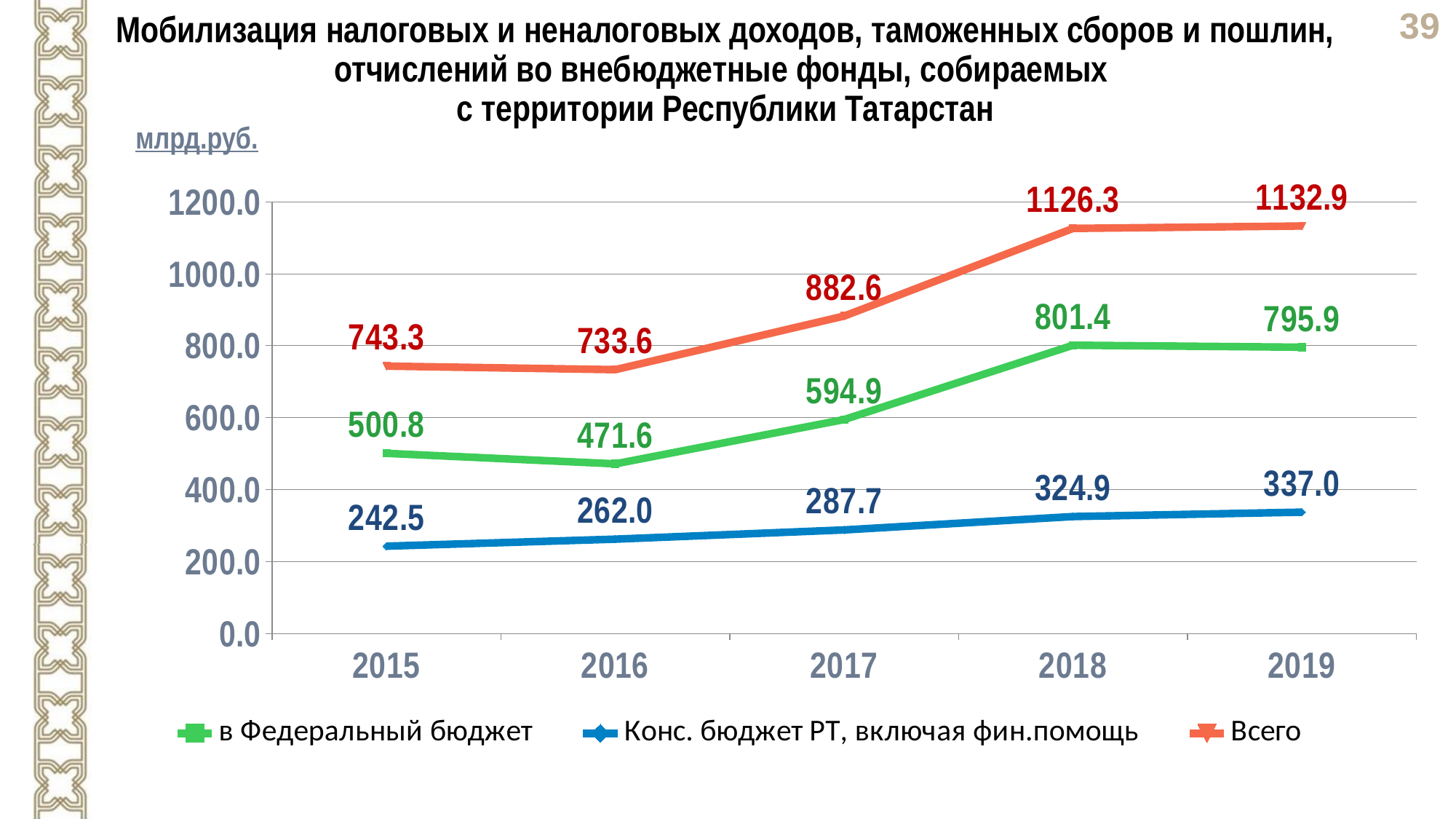
What is the difference between the 'Конс. бюджет РТ, включая фин.помощь' values in 2019 and 2015? 94.5 In which year is the 'Всего' series at its lowest? 2016 What is the value of the 'Конс. бюджет РТ, включая фин.помощь' series in 2017? 287.7 In which year is the 'в Федеральный бюджет' series at its highest? 2018 What kind of chart is shown on the slide? line chart How many years are shown on the x axis? 5 What is the value of the 'Всего' series in 2019? 1132.9 How many series does the legend list? 3 What is the value of the 'в Федеральный бюджет' series in 2016? 471.6 What is the difference between the 'Всего' values in 2018 and 2017? 243.7 Does the 'Конс. бюджет РТ, включая фин.помощь' series rise or fall from 2015 to 2019? rise Which is larger: the 'в Федеральный бюджет' value in 2015 or in 2017? 2017